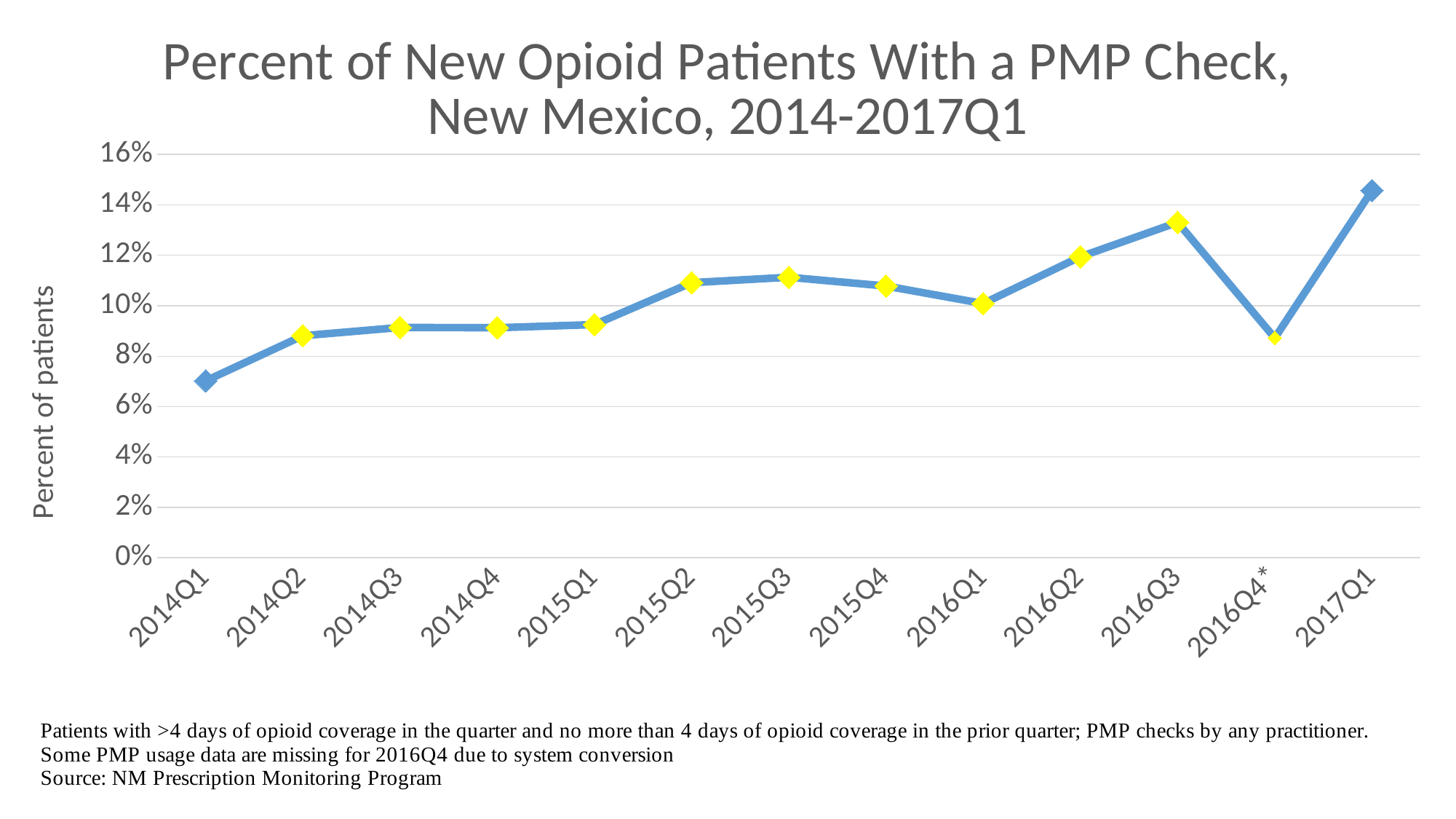
Which is larger, the value for 2016Q3 or the value for 2016Q4*? 2016Q3 Is the value for 2016Q3 greater or less than 12%? greater Which is larger, the value for 2015Q2 or the value for 2014Q1? 2015Q2 Is the value for 2016Q4* greater or less than 10%? less What is the label on the vertical axis? Percent of patients Which quarter has the highest percent of new opioid patients with a PMP check? 2017Q1 Is the value for 2014Q1 greater or less than 8%? less What kind of chart is shown on the slide? line chart How many quarters are plotted on the x axis? 13 Which quarter has the lowest percent of new opioid patients with a PMP check? 2014Q1 Overall, does the percent of patients rise or fall from 2014Q1 to 2017Q1? rise